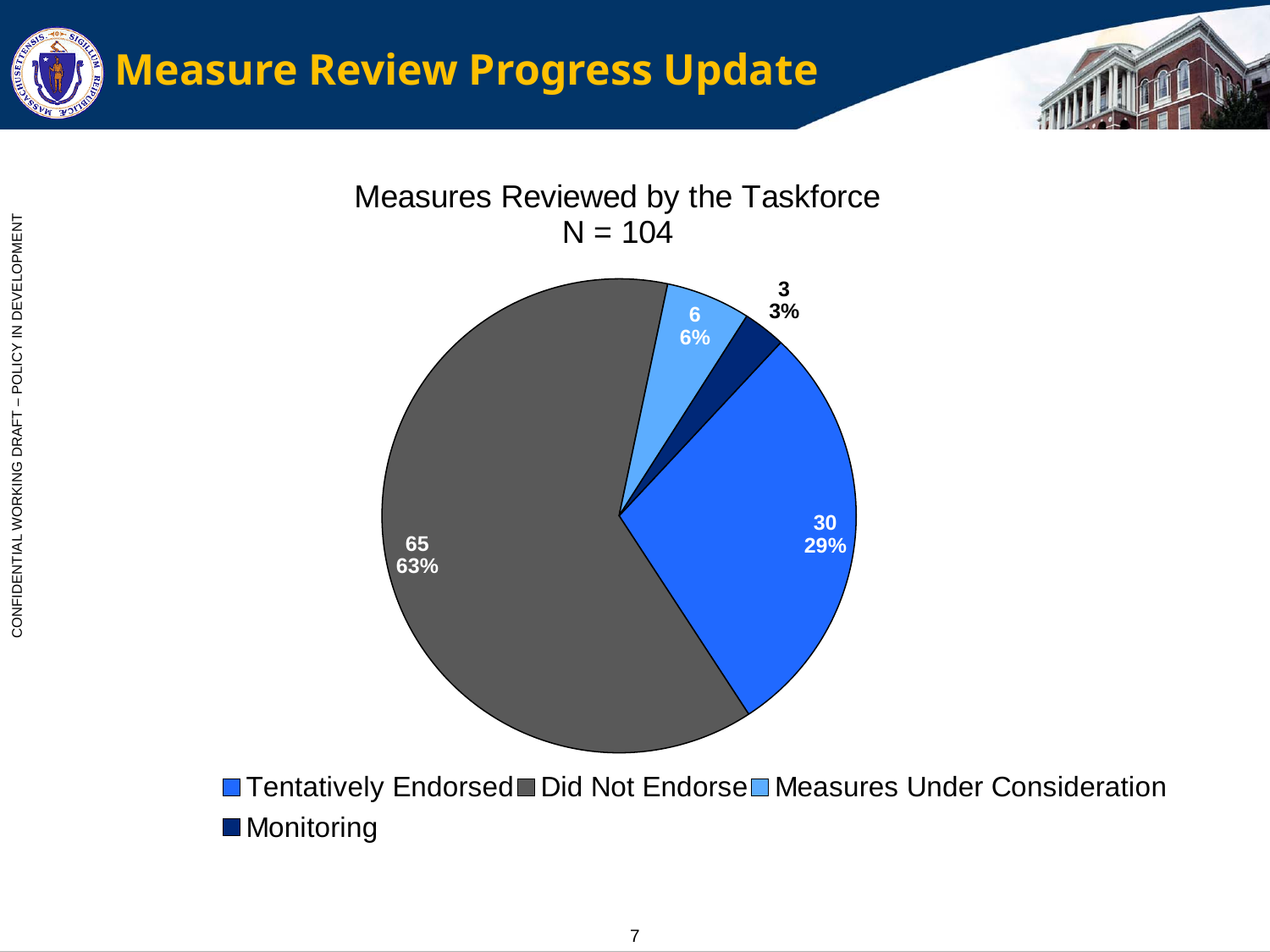
How many measures fall under Did Not Endorse? 65 How many measures are in the Monitoring category? 3 What is the difference between the number of measures Did Not Endorse and Tentatively Endorsed? 35 What is the title of the chart? Measures Reviewed by the Taskforce N = 104 What type of chart is shown on the slide? pie chart How many categories does the legend list? 4 What share of the pie does Did Not Endorse represent? 63% Which category has the largest slice of the pie? Did Not Endorse How many measures are Under Consideration? 6 How many measures were Tentatively Endorsed? 30 Which category has the smallest slice of the pie? Monitoring What share of the pie does Tentatively Endorsed represent? 29%